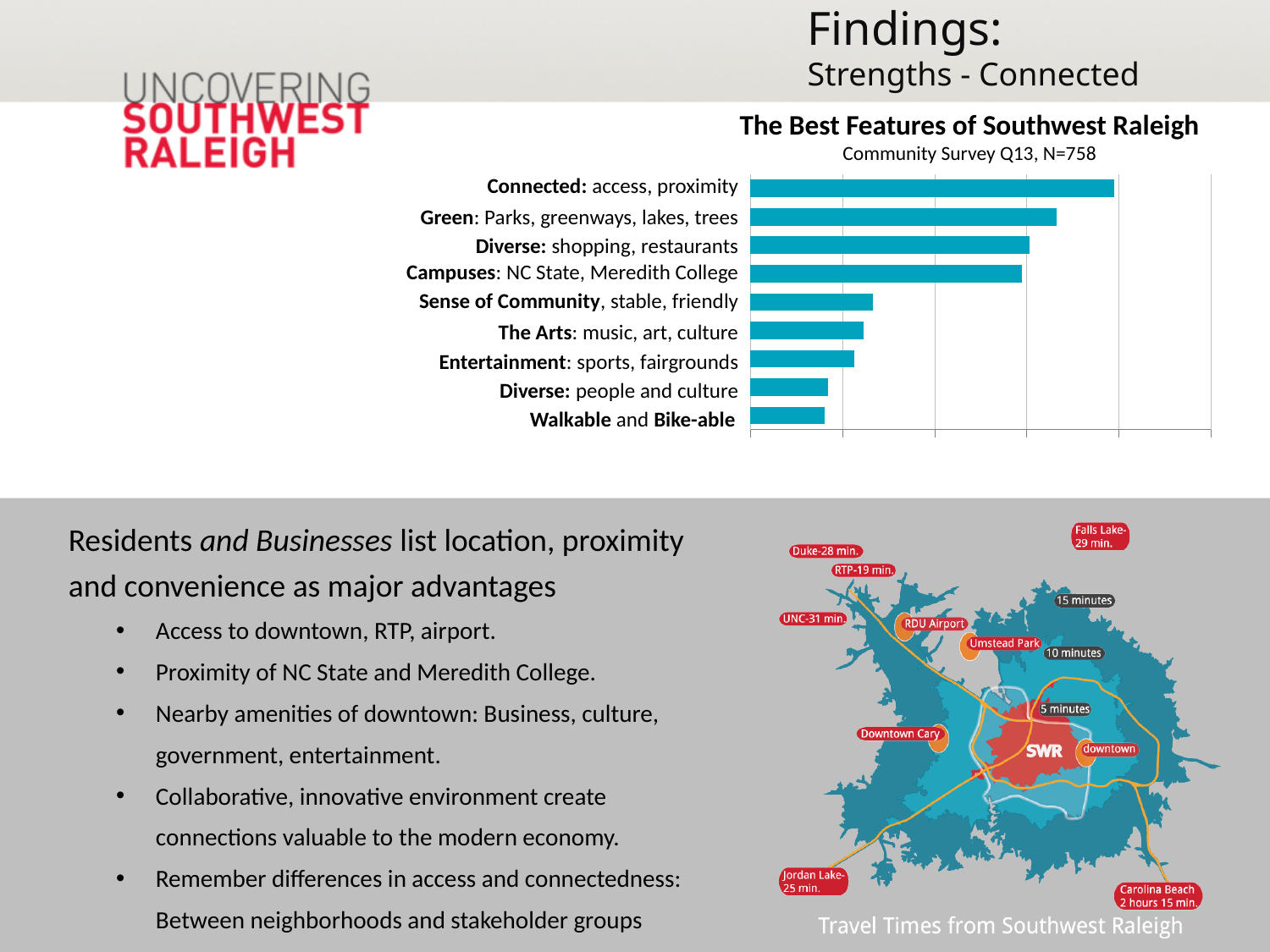
According to the subtitle of The Best Features of Southwest Raleigh chart, what is the survey sample size N? 758 In The Best Features of Southwest Raleigh chart, do the bar lengths increase or decrease going from the top category to the bottom category? Decrease In The Best Features of Southwest Raleigh chart, which has the larger value: Green: Parks, greenways, lakes, trees or Diverse: shopping, restaurants? Green: Parks, greenways, lakes, trees In The Best Features of Southwest Raleigh chart, which has the larger value: Connected: access, proximity or Green: Parks, greenways, lakes, trees? Connected: access, proximity Which feature has the longest bar in The Best Features of Southwest Raleigh chart? Connected: access, proximity In The Best Features of Southwest Raleigh chart, which has the larger value: Campuses: NC State, Meredith College or Sense of Community, stable, friendly? Campuses: NC State, Meredith College What kind of chart is used to show The Best Features of Southwest Raleigh? Bar chart What is the title of the bar chart on the slide? The Best Features of Southwest Raleigh How many features are listed as categories in The Best Features of Southwest Raleigh chart? 9